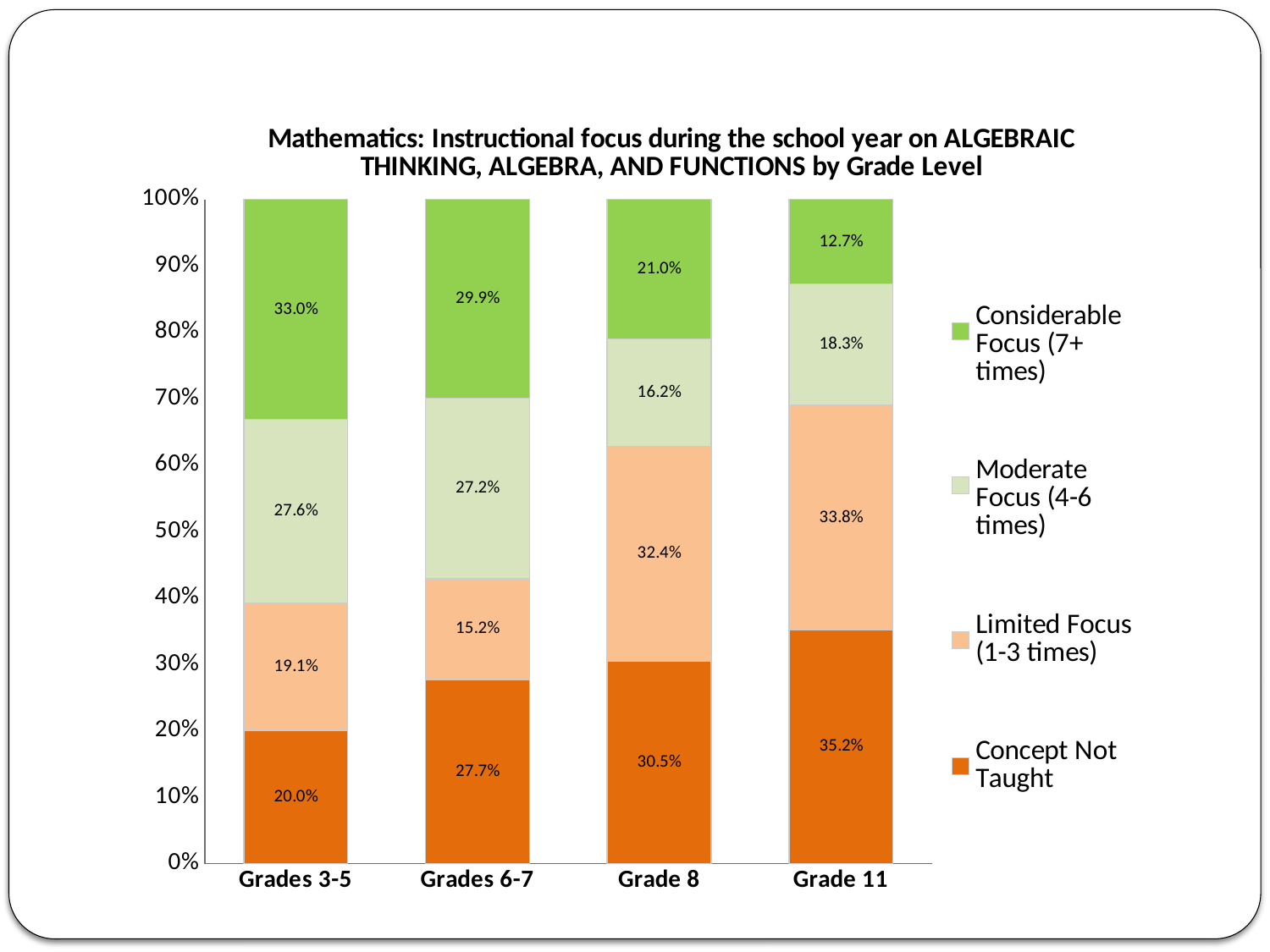
Which is larger: the Limited Focus (1-3 times) value for Grades 3-5 or for Grades 6-7? Grades 3-5 What is the Limited Focus (1-3 times) value for Grade 8? 32.4% What is the Moderate Focus (4-6 times) value for Grades 6-7? 27.2% What percentage of Grades 3-5 teachers reported Considerable Focus (7+ times)? 33.0% Which grade level has the lowest Considerable Focus (7+ times) percentage? Grade 11 What is the difference between the Considerable Focus (7+ times) values for Grades 3-5 and Grade 11? 20.3% What kind of chart is shown on the slide? Stacked bar chart How many series does the legend list? 4 How many grade-level categories are shown on the x axis? 4 Which grade level has the highest Concept Not Taught percentage? Grade 11 What is the Concept Not Taught value for Grade 11? 35.2% Does the Concept Not Taught percentage rise or fall from Grades 3-5 to Grade 11? Rise